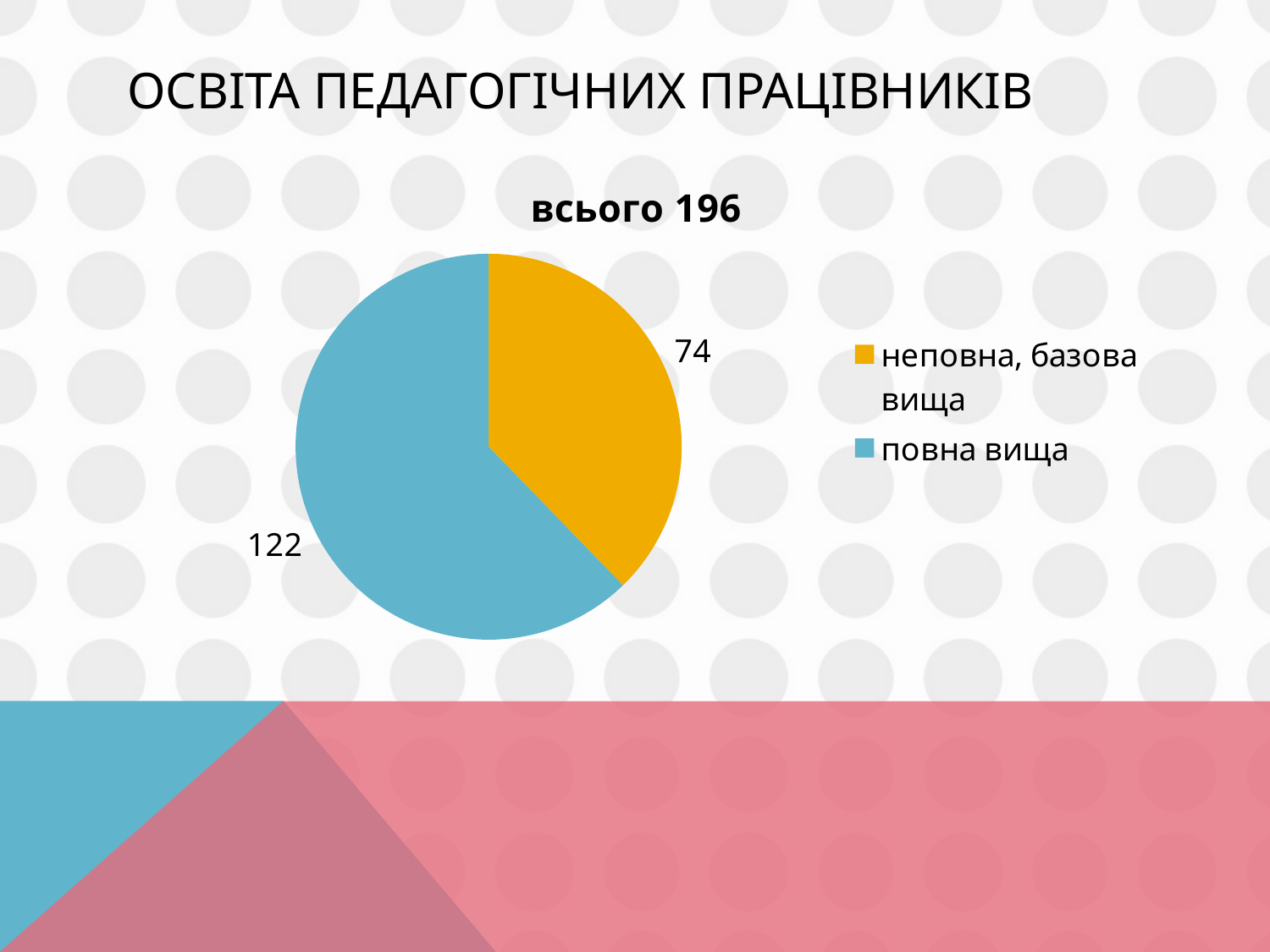
What is the value for "повна вища"? 122 What type of chart is shown on the slide? pie chart Which category has the largest slice of the pie? повна вища Which category has the smallest slice of the pie? неповна, базова вища What is the value for "неповна, базова вища"? 74 What is the title of the chart? всього 196 How many categories does the pie chart have? 2 What colour is the slice for "повна вища"? blue What share of the total does "неповна, базова вища" represent, to one decimal place? 37.8% What is the difference between the values for "повна вища" and "неповна, базова вища"? 48 What is the total of all slices in the pie chart? 196 Which is larger: the value for "повна вища" or for "неповна, базова вища"? повна вища